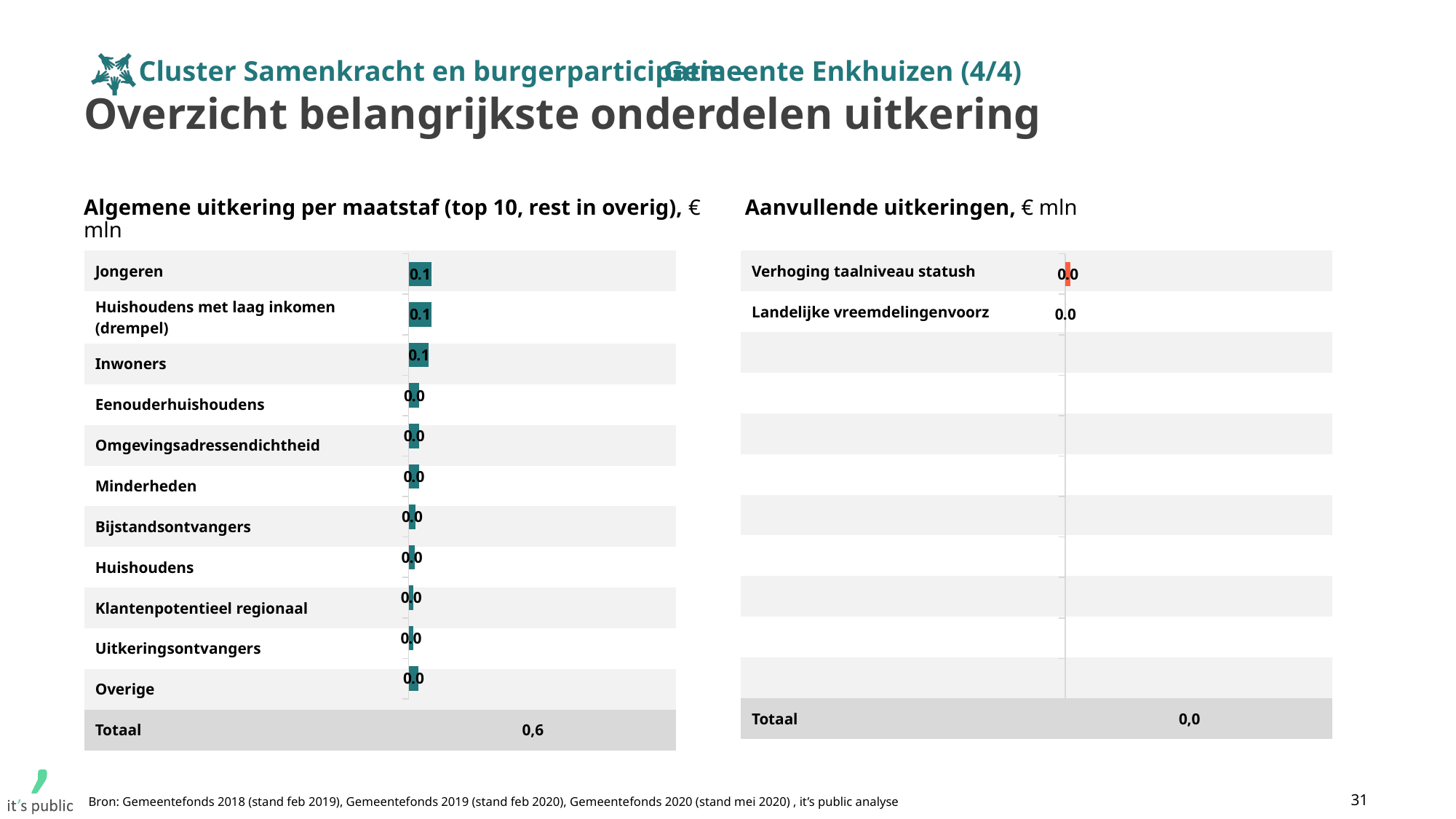
In the chart 'Algemene uitkering per maatstaf', what is the value for Eenouderhuishoudens? 0.0 In the chart 'Algemene uitkering per maatstaf', what is the value for Inwoners? 0.1 What is the Totaal shown for the chart 'Algemene uitkering per maatstaf'? 0,6 In the chart 'Algemene uitkering per maatstaf', which is larger: the value for Jongeren or the value for Overige? Jongeren In the chart 'Algemene uitkering per maatstaf', what is the difference between the value for Huishoudens met laag inkomen (drempel) and the value for Minderheden? 0.1 In the chart 'Algemene uitkering per maatstaf', what is the value for Jongeren? 0.1 What kind of chart is 'Algemene uitkering per maatstaf'? Bar chart In the chart 'Aanvullende uitkeringen', what is the value for Verhoging taalniveau statush? 0.0 How many categories are shown in the chart 'Aanvullende uitkeringen'? 2 How many categories are shown in the chart 'Algemene uitkering per maatstaf'? 11 What unit is stated in the title of the chart 'Aanvullende uitkeringen'? € mln What is the Totaal shown for the chart 'Aanvullende uitkeringen'? 0,0